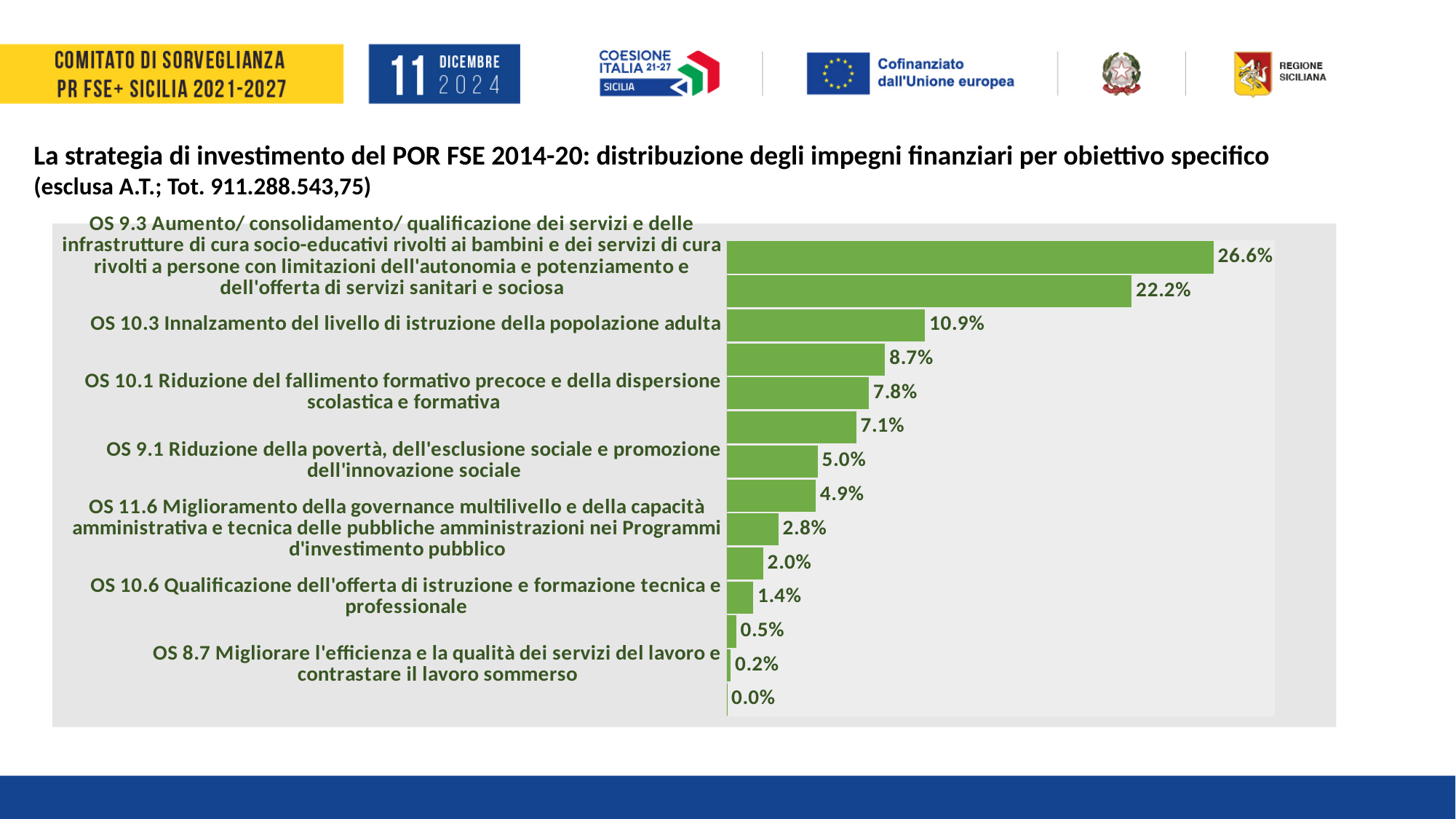
What is the value for OS 10.1 Riduzione del fallimento formativo precoce e della dispersione scolastica e formativa? 7.8% What is the value for OS 10.3 Innalzamento del livello di istruzione della popolazione adulta? 10.9% What is the value for OS 8.7 Migliorare l'efficienza e la qualità dei servizi del lavoro e contrastare il lavoro sommerso? 0.2% Which has a larger value, OS 9.1 or OS 10.6? OS 9.1 How many bars are plotted in the chart? 14 What is the lowest value shown in the chart? 0.0% What is the highest value shown in the chart? 26.6% What kind of chart is shown on the slide? bar chart What is the value for OS 9.3 (Aumento/ consolidamento/ qualificazione dei servizi e delle infrastrutture di cura socio-educativi)? 26.6% What is the difference between the values for OS 10.3 and OS 10.1? 3.1% What is the value for OS 11.6 Miglioramento della governance multilivello? 2.8% What is the value for OS 9.1 Riduzione della povertà, dell'esclusione sociale e promozione dell'innovazione sociale? 5.0%